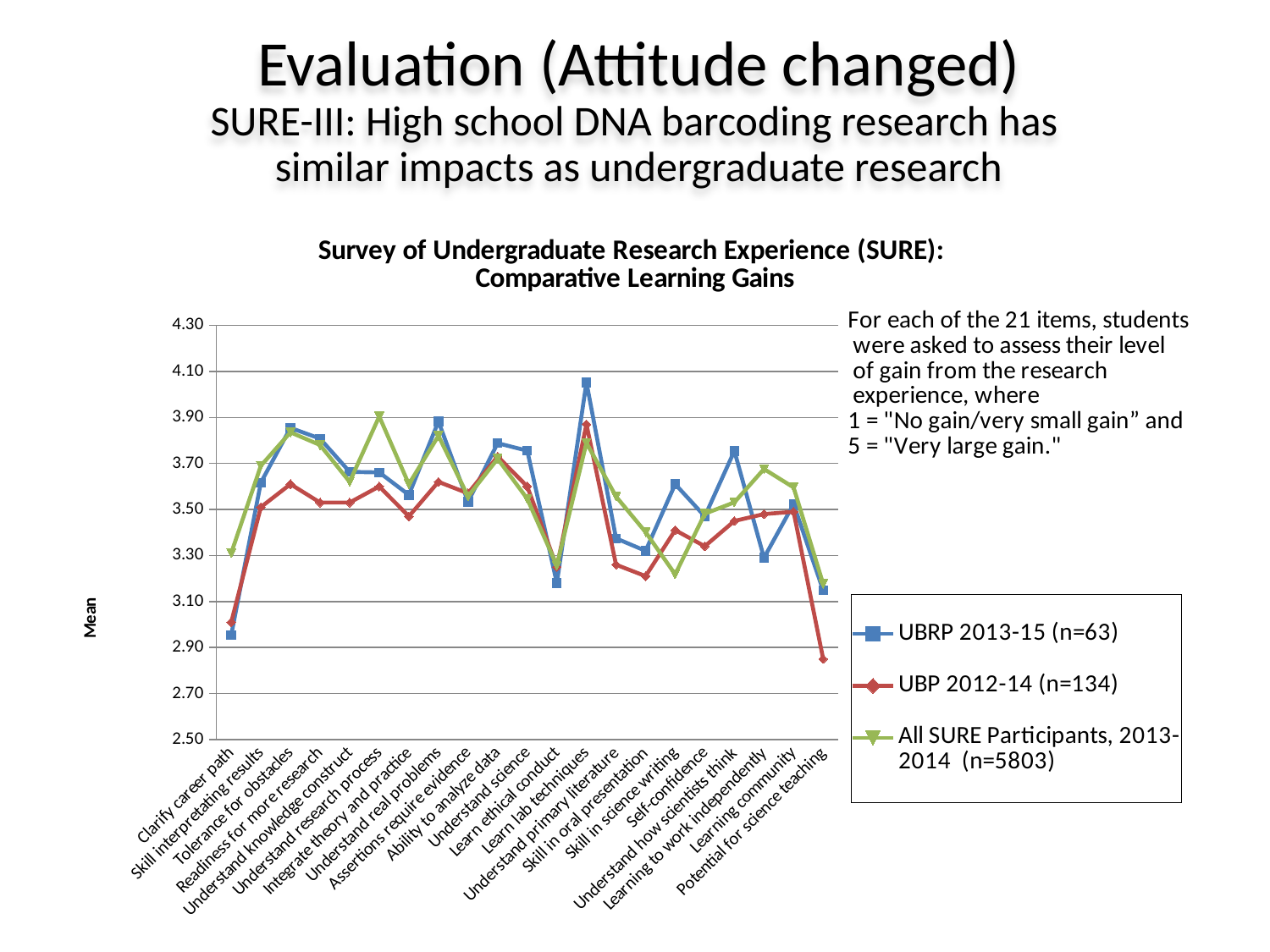
How many items (categories) are plotted along the x axis of the chart? 21 How many series does the chart legend list? 3 For the UBRP 2013-15 (n=63) series, which item has the lowest mean? Clarify career path For the UBP 2012-14 (n=134) series, which item has the lowest mean? Potential for science teaching What kind of chart is shown on the slide? line chart Is the UBRP 2013-15 (n=63) value for Learn lab techniques greater or less than 3.90? greater For the All SURE Participants, 2013-2014 (n=5803) series, which item has the highest mean? Understand research process For the UBRP 2013-15 (n=63) series, which item has the highest mean? Learn lab techniques What is the title of the chart? Survey of Undergraduate Research Experience (SURE): Comparative Learning Gains For Learn lab techniques, which series has the larger value: UBRP 2013-15 (n=63) or UBP 2012-14 (n=134)? UBRP 2013-15 (n=63) What is the label on the chart's vertical axis? Mean Is the UBRP 2013-15 (n=63) value for Clarify career path greater or less than 3.10? less